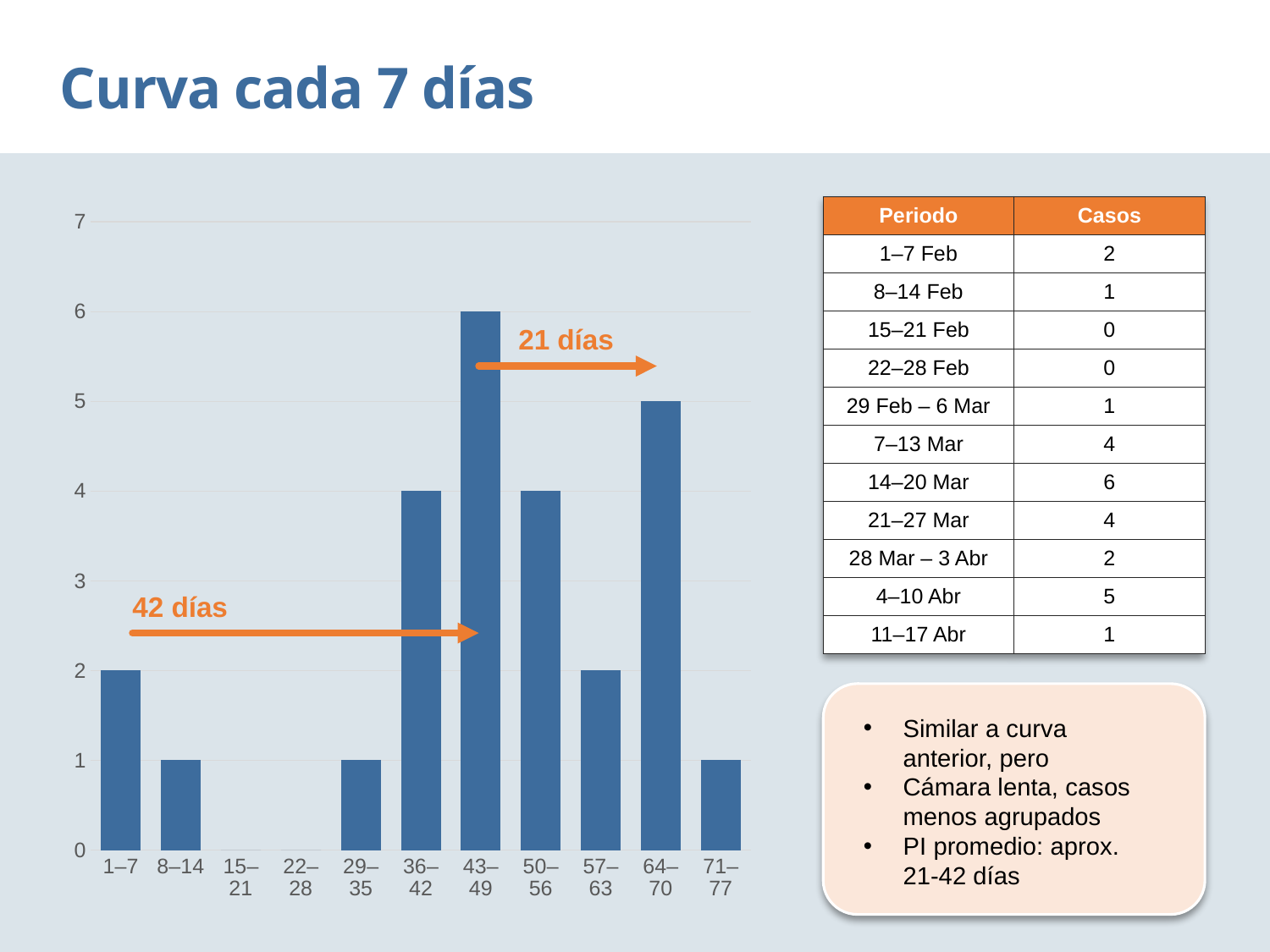
Which period has the highest bar in the chart? 43–49 What label is written on the longer orange arrow in the chart? 42 días What is the value of the bar for the 64–70 period? 5 How many periods in the chart have a value of 0? 2 What is the difference between the values for the 43–49 period and the 64–70 period? 1 What type of chart is shown on the slide? bar chart How many categories (7-day periods) are shown on the x axis of the chart? 11 What is the title of the slide containing the chart? Curva cada 7 días Which is larger, the value for the 36–42 period or the value for the 57–63 period? 36–42 What is the value of the bar for the 43–49 period? 6 What is the value of the bar for the 1–7 period? 2 Is the value for the 64–70 period greater or less than 3? greater